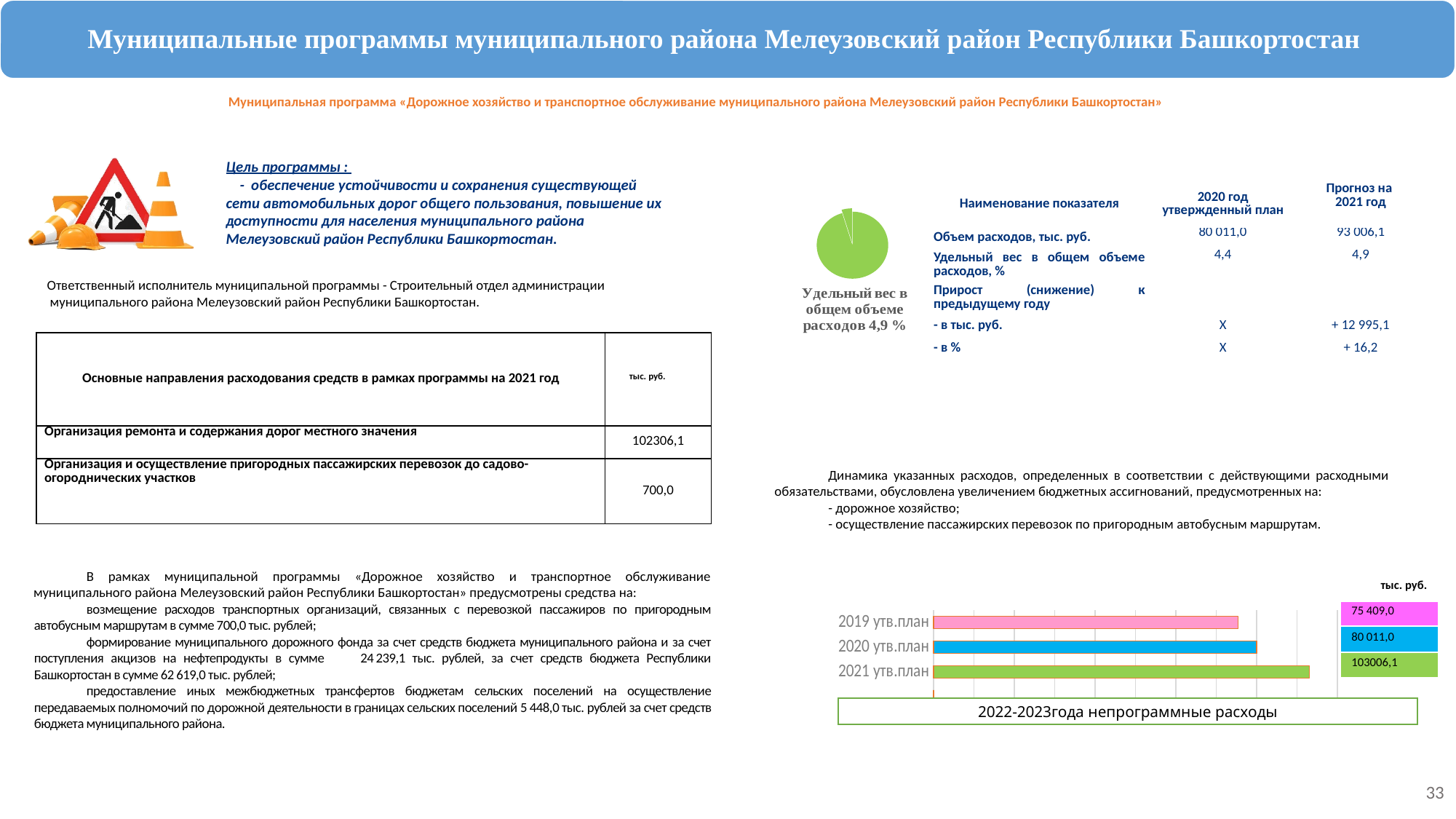
In the bar chart at the bottom right, what is the difference between the 2020 утв.план and 2019 утв.план values? 4 602,0 In the bar chart at the bottom right, how many bars (years) are shown? 3 In the bar chart at the bottom right, do the values rise or fall from 2019 to 2021? rise In the bar chart at the bottom right, what unit is indicated above the data labels? тыс. руб. In the bar chart at the bottom right, what is the value for 2021 утв.план? 103006,1 In the bar chart at the bottom right, which year has the highest value? 2021 утв.план What kind of chart is the chart at the bottom right of the slide showing утв.план values by year? bar chart According to the pie chart on the right side of the slide, what share of total expenditures does the programme represent? 4,9 % In the bar chart at the bottom right, what is the value for 2019 утв.план? 75 409,0 In the bar chart at the bottom right, which year has the lowest value? 2019 утв.план In the bar chart at the bottom right, what is the value for 2020 утв.план? 80 011,0 In the bar chart at the bottom right, which is larger: the value for 2020 утв.план or 2019 утв.план? 2020 утв.план